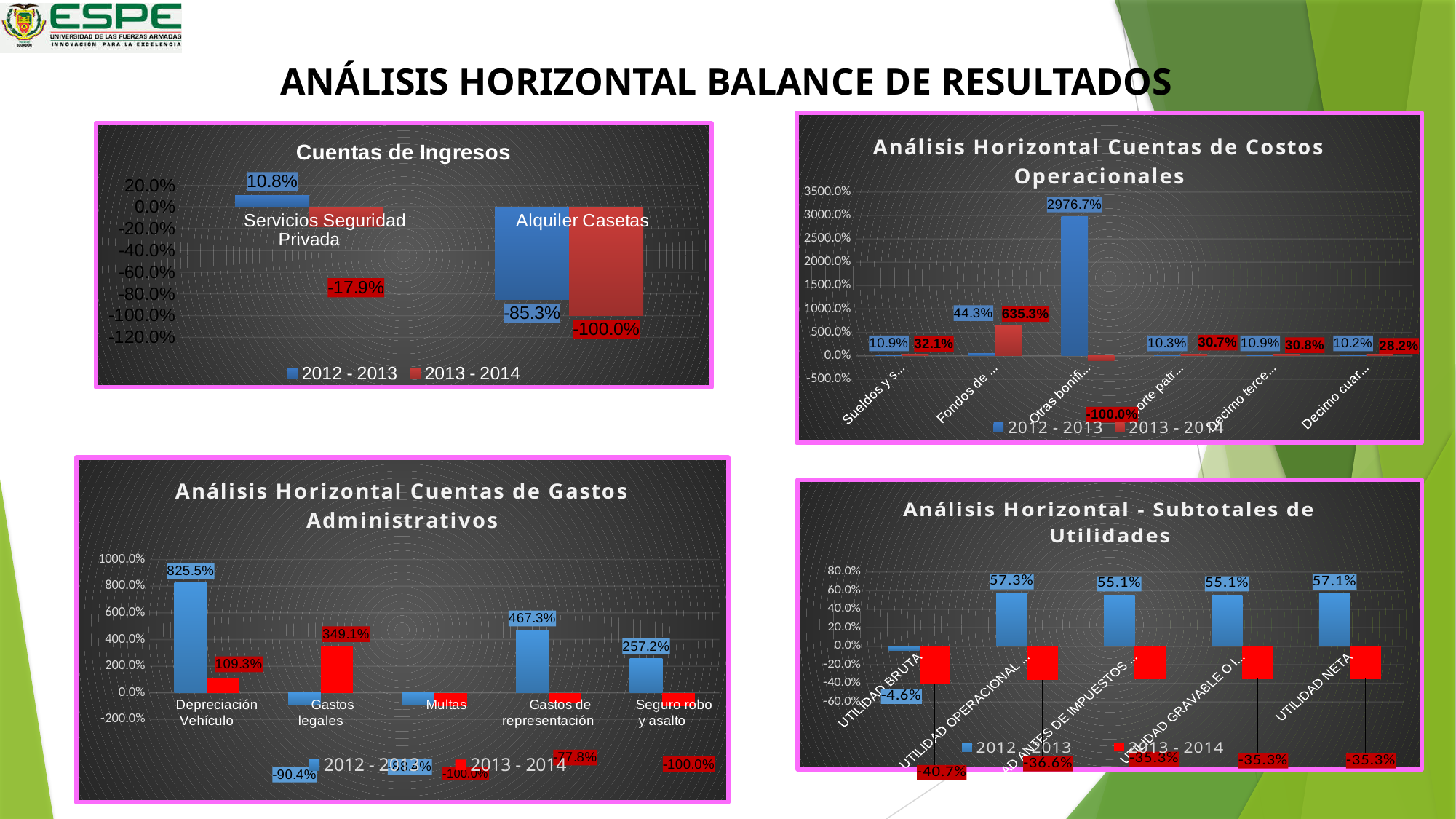
In the 'Análisis Horizontal Cuentas de Gastos Administrativos' chart, what is the 2012 - 2013 value for Depreciación Vehículo? 825.5% What kind of chart is 'Análisis Horizontal - Subtotales de Utilidades'? Bar chart In the 'Cuentas de Ingresos' chart, what is the 2012 - 2013 value for Servicios Seguridad Privada? 10.8% In the 'Análisis Horizontal Cuentas de Costos Operacionales' chart, what is the 2013 - 2014 value for the category 'Fondos de ...'? 635.3% In the 'Análisis Horizontal - Subtotales de Utilidades' chart, what is the 2012 - 2013 value for UTILIDAD NETA? 57.1% In the 'Análisis Horizontal Cuentas de Gastos Administrativos' chart, what is the 2013 - 2014 value for Gastos legales? 349.1% In the 'Cuentas de Ingresos' chart, what is the 2013 - 2014 value for Alquiler Casetas? -100.0% In the 'Análisis Horizontal Cuentas de Costos Operacionales' chart, what is the highest value shown? 2976.7% In the 'Análisis Horizontal - Subtotales de Utilidades' chart, what is the 2013 - 2014 value for UTILIDAD BRUTA? -40.7% In the 'Cuentas de Ingresos' chart, how many series does the legend list? 2 In the 'Análisis Horizontal Cuentas de Gastos Administrativos' chart, which category has the highest 2012 - 2013 value? Depreciación Vehículo In the 'Análisis Horizontal Cuentas de Gastos Administrativos' chart, how many categories are shown on the x axis? 5